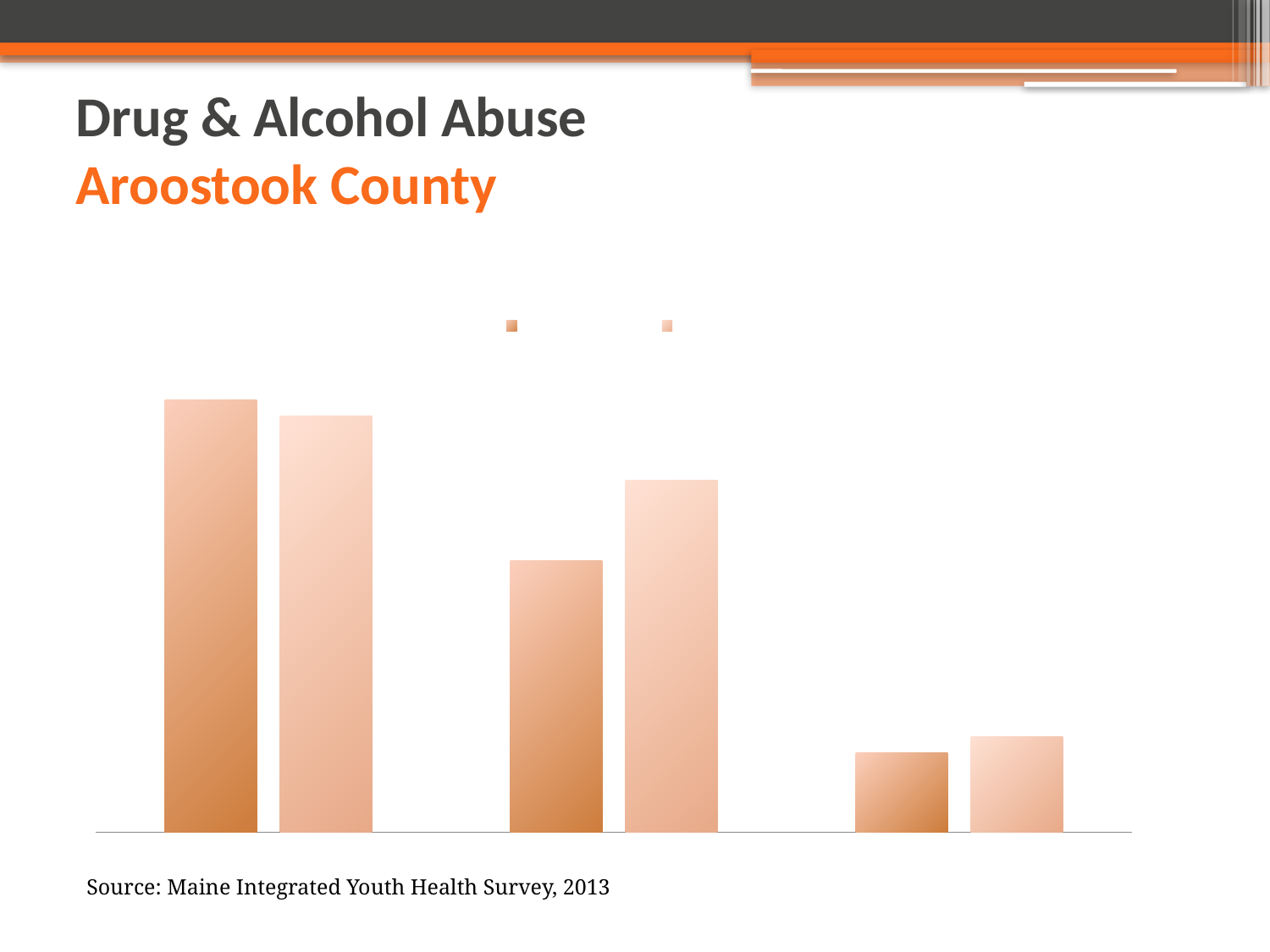
In the left group, is the darker orange bar or the lighter orange bar taller? the darker orange bar How many bars are plotted in total on the chart? 6 In the middle group, is the darker orange bar or the lighter orange bar taller? the lighter orange bar How many series does the legend indicate? 2 Which group of bars is the shortest: the left, middle, or right group? right Which group of bars is the tallest: the left, middle, or right group? left What county is named in the slide title? Aroostook County Do the bar heights generally rise or fall from left to right across the groups? fall How many groups of bars are plotted on the chart? 3 What kind of chart is shown on the slide? bar chart What source is cited below the chart? Maine Integrated Youth Health Survey, 2013